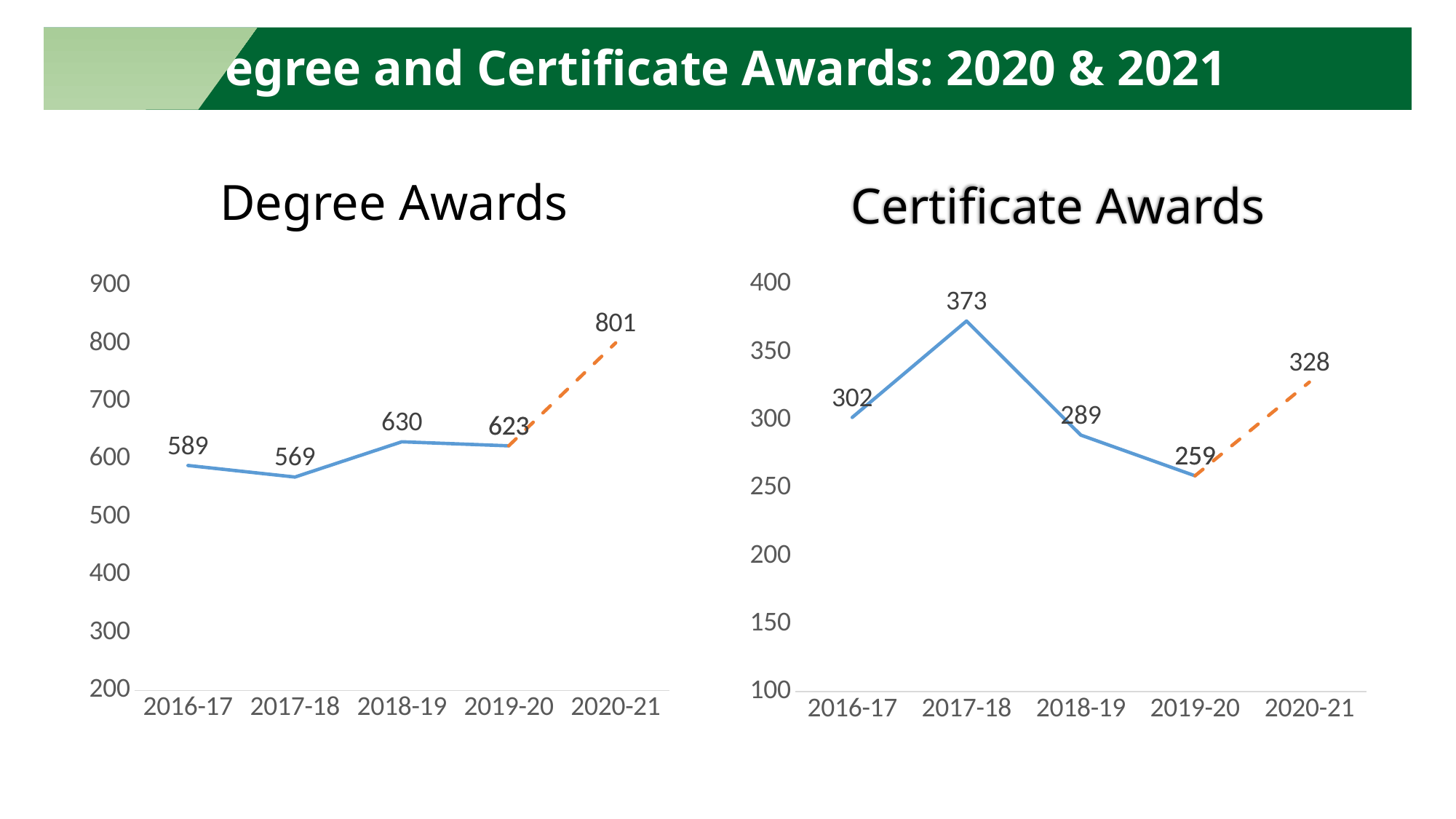
In the Degree Awards chart, what is the difference between the 2020-21 and 2019-20 values? 178 In the Degree Awards chart, what is the value for 2017-18? 569 In the Degree Awards chart, which year has the lowest value? 2017-18 In the Degree Awards chart, what is the value for 2020-21? 801 What kind of chart is the Certificate Awards chart? Line chart In the Certificate Awards chart, which is larger, the value for 2016-17 or 2018-19? 2016-17 In the Certificate Awards chart, which year has the highest value? 2017-18 In the Certificate Awards chart, what is the value for 2017-18? 373 In the Certificate Awards chart, what is the value for 2019-20? 259 In the Certificate Awards chart, what is the difference between the 2017-18 and 2019-20 values? 114 In the Certificate Awards chart, do the values rise or fall from 2017-18 to 2019-20? Fall How many years are plotted on the x axis of the Degree Awards chart? 5